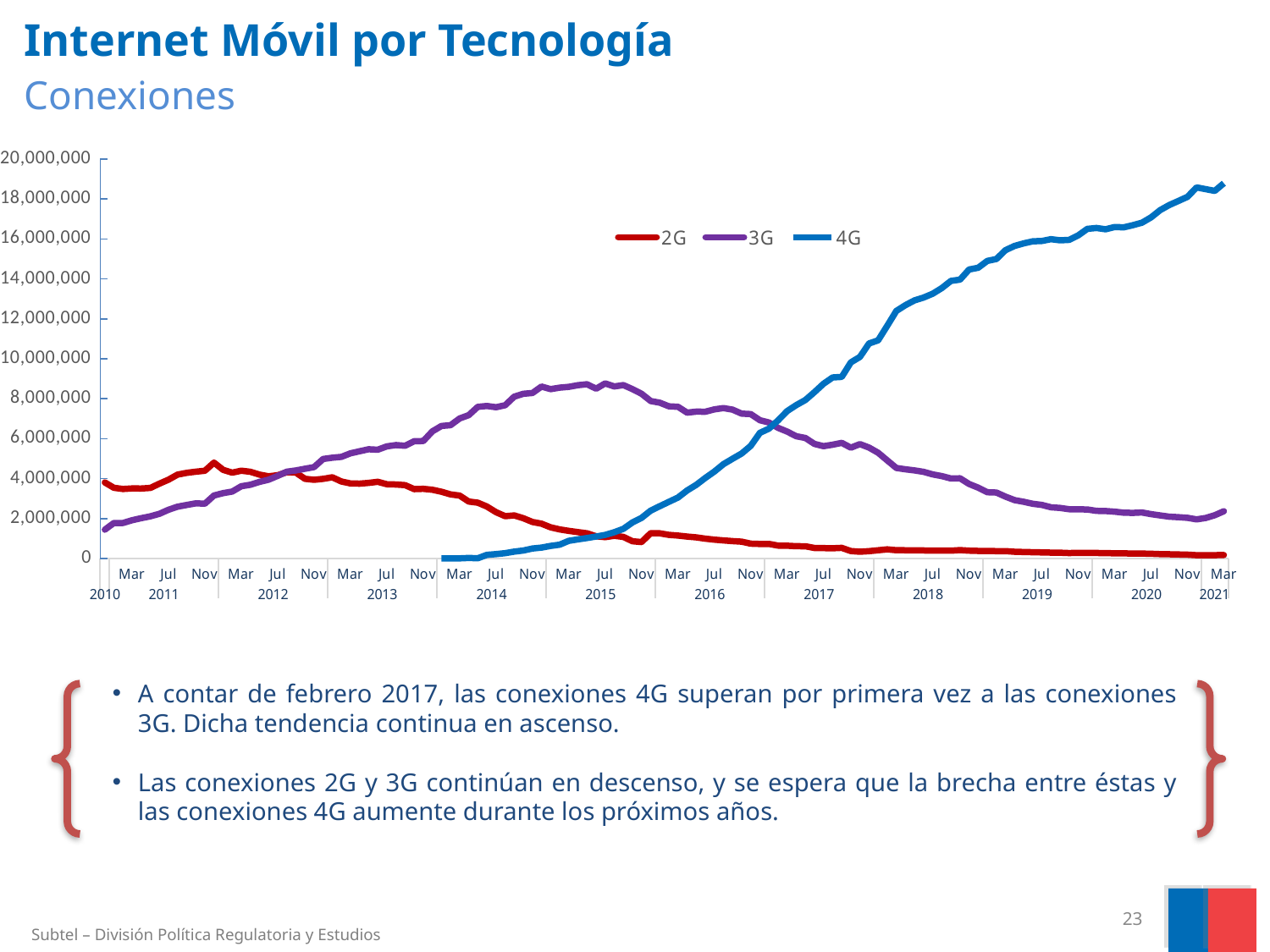
Which series has the highest value at Mar 2021? 4G Is the value for 2G at Mar 2021 greater or less than 2,000,000? less Which series has the lowest value at Mar 2021? 2G Does the 4G series rise or fall along the x axis from 2014 to 2021? rise Does the 2G series rise or fall along the x axis from 2013 to 2021? fall What kind of chart is shown on the slide? line chart How many series does the legend list? 3 Is the value for 4G at Mar 2021 greater or less than 18,000,000? greater Which series has the highest value at the start of 2010? 2G What are the series names listed in the legend? 2G, 3G, 4G Which series has the higher value at Mar 2021, 3G or 2G? 3G Is the value for 3G at Mar 2021 greater or less than 4,000,000? less